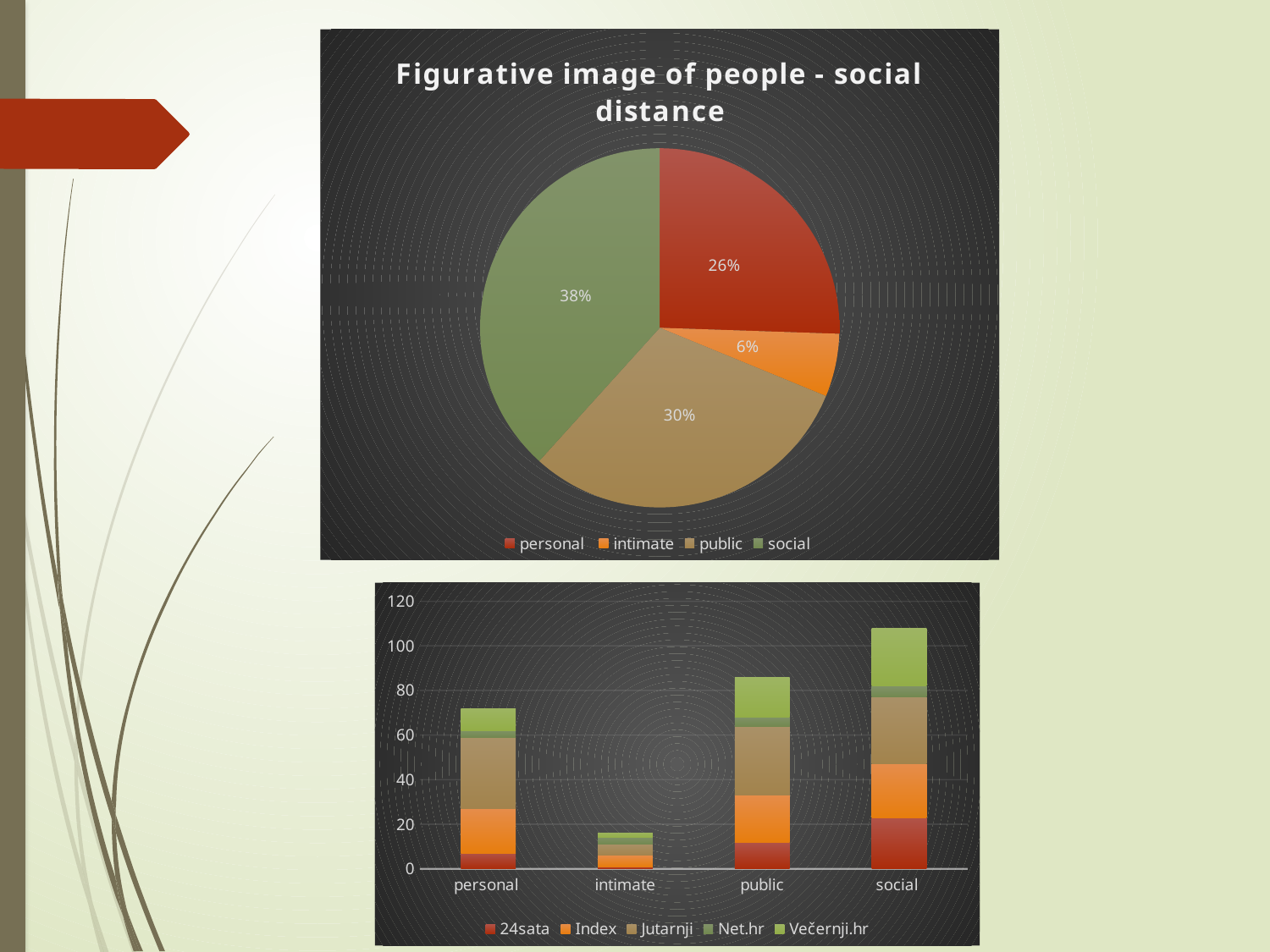
How many slices does the pie chart titled 'Figurative image of people - social distance' have? 4 In the pie chart titled 'Figurative image of people - social distance', what is the difference between the 'social' and 'personal' shares? 12% What kind of chart is the chart at the bottom of the slide? stacked bar chart In the pie chart titled 'Figurative image of people - social distance', what share does the 'public' slice have? 30% In the bottom stacked bar chart, is the total stacked value for 'intimate' greater or less than 20? less In the pie chart titled 'Figurative image of people - social distance', which category has the smallest share? intimate In the pie chart titled 'Figurative image of people - social distance', what share does the 'social' slice have? 38% In the pie chart titled 'Figurative image of people - social distance', what share does the 'intimate' slice have? 6% In the pie chart titled 'Figurative image of people - social distance', which category has the largest share? social In the pie chart titled 'Figurative image of people - social distance', which is larger, the 'public' share or the 'personal' share? public How many series does the legend of the bottom stacked bar chart list? 5 In the bottom stacked bar chart, which category has the tallest stacked bar? social